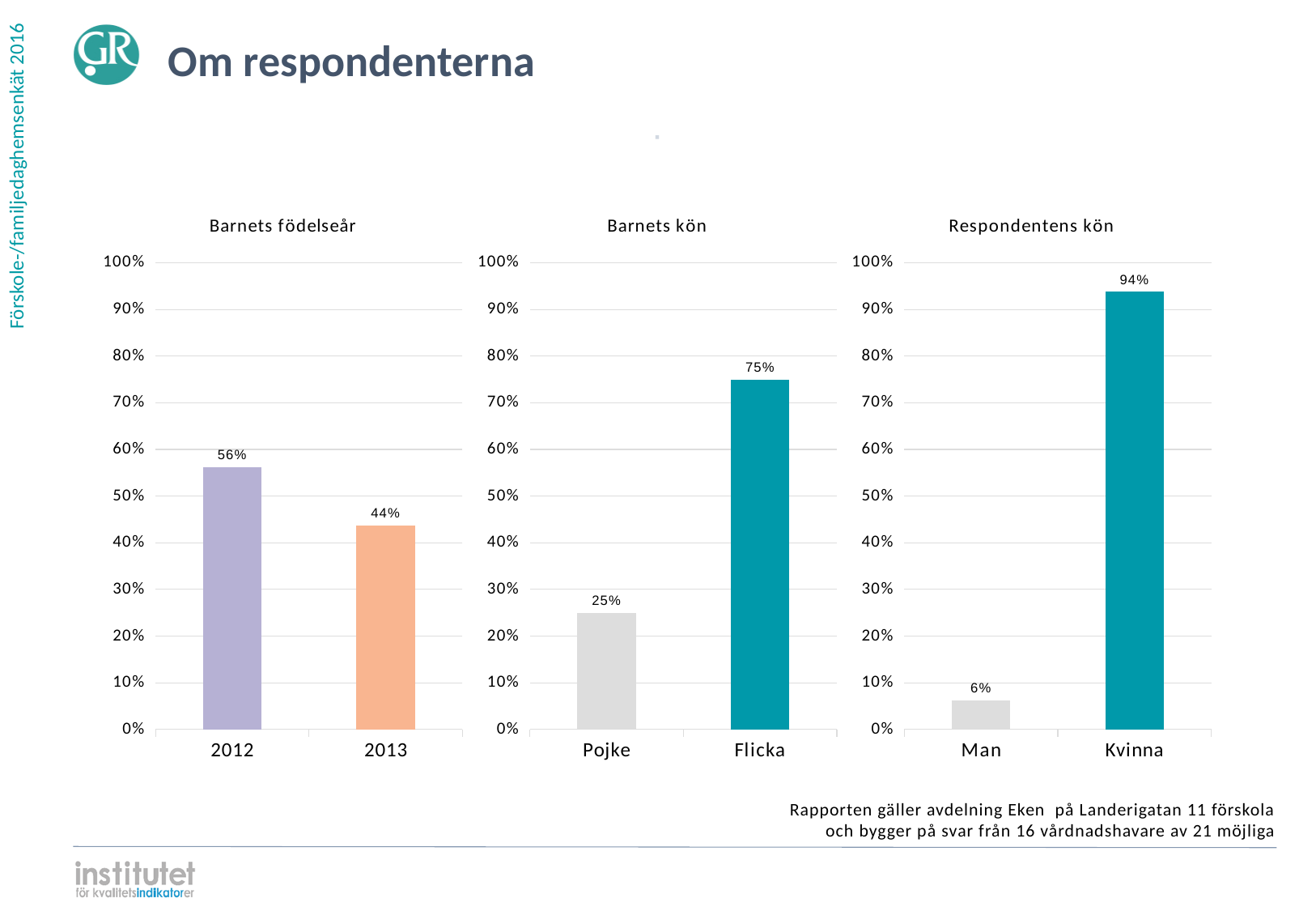
How many categories does the 'Barnets kön' chart show? 2 In the 'Respondentens kön' chart, what is the value for Kvinna? 94% In the 'Barnets kön' chart, what is the value for Pojke? 25% In the 'Barnets kön' chart, what is the difference between Flicka and Pojke? 50% In the 'Barnets födelseår' chart, which is larger, 2012 or 2013? 2012 In the 'Respondentens kön' chart, which category has the lowest value? Man In the 'Barnets kön' chart, what is the value for Flicka? 75% In the 'Barnets födelseår' chart, what is the value for 2013? 44% In the 'Barnets födelseår' chart, what is the difference between 2012 and 2013? 12% In the 'Respondentens kön' chart, is the value for Man greater or less than 10%? less What kind of chart is the 'Respondentens kön' chart? bar chart In the 'Barnets födelseår' chart, what is the value for 2012? 56%